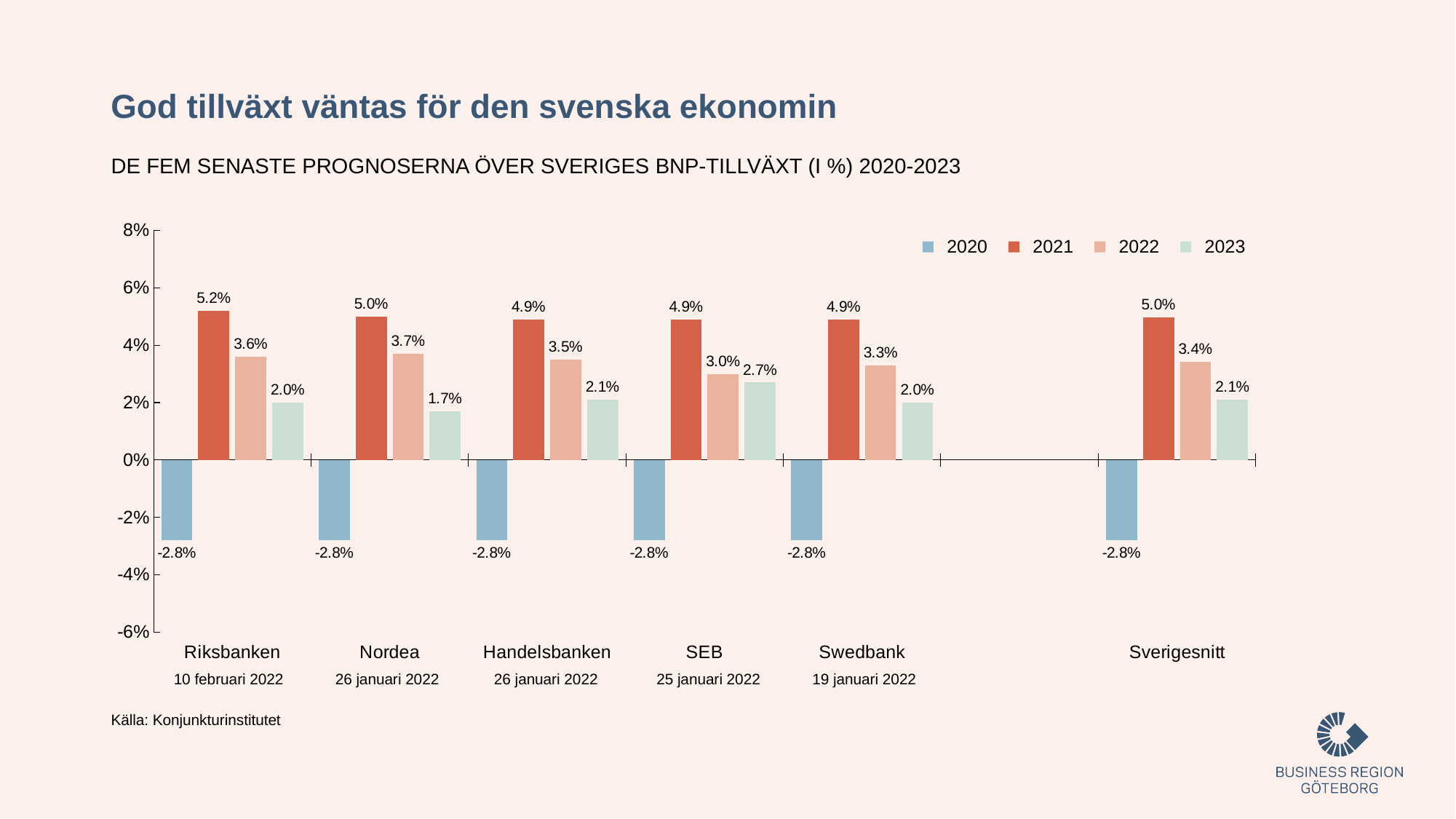
Which is larger, the 2022 value for Nordea or the 2022 value for Swedbank? Nordea Which forecaster has the highest 2021 value? Riksbanken Which forecaster has the lowest 2023 value? Nordea What is the 2022 value for Sverigesnitt? 3.4% What is the 2020 value for Nordea? -2.8% What kind of chart is shown on the slide? Bar chart What is the 2023 forecast value for SEB? 2.7% How many series does the legend list? 4 How many forecasters (categories) are labelled on the x axis? 6 What is the 2021 forecast value for Riksbanken? 5.2% What is the difference between the 2022 and 2023 values for Handelsbanken? 1.4% What is the source cited below the chart? Konjunkturinstitutet